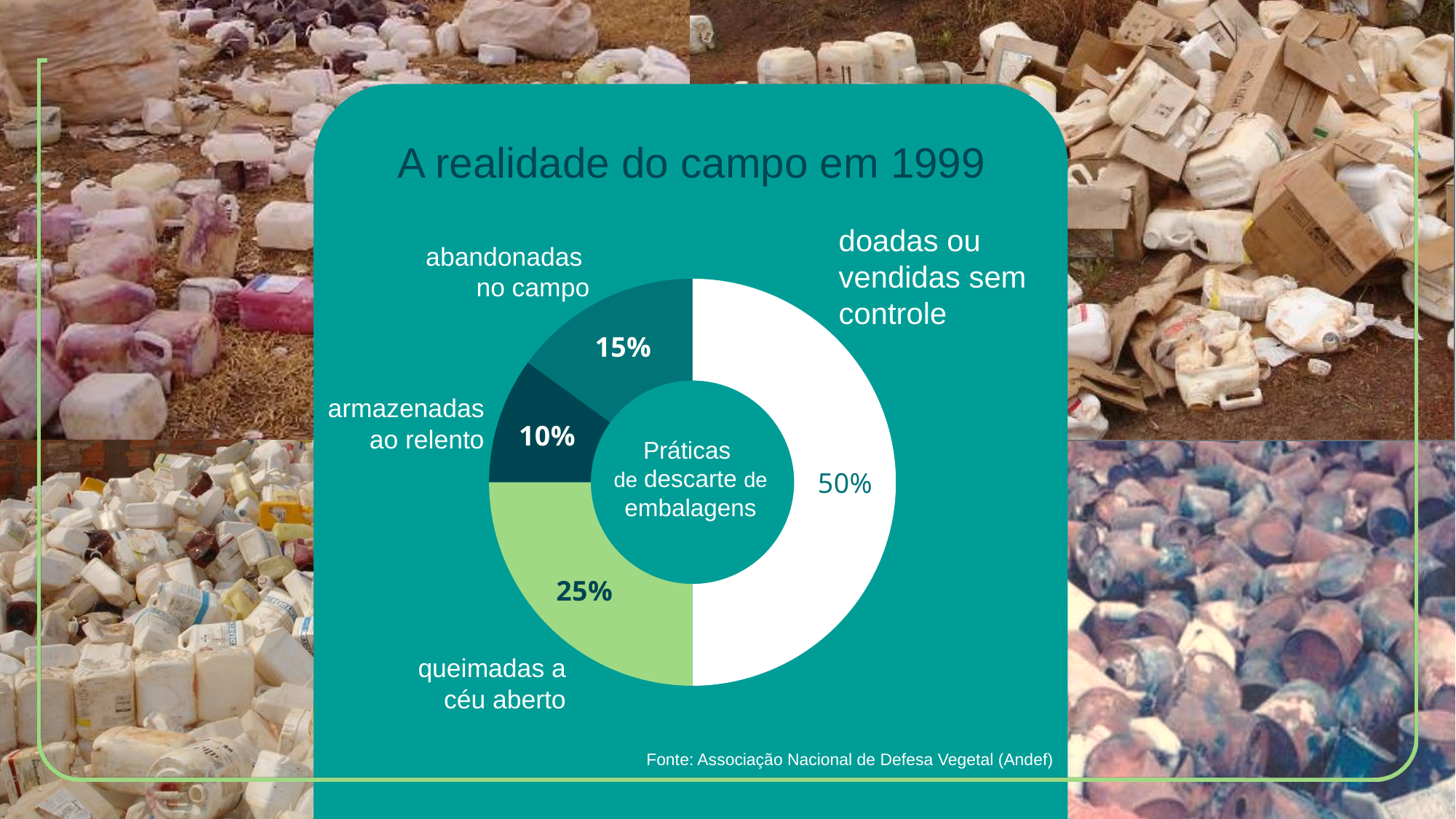
What text appears in the centre of the pie chart? Práticas de descarte de embalagens What is the title of the slide containing the chart? A realidade do campo em 1999 What value is shown for 'abandonadas no campo'? 15% What kind of chart is shown on the slide? doughnut chart What is the difference between the shares for 'queimadas a céu aberto' and 'abandonadas no campo'? 10% Which category has the largest share of the pie? doadas ou vendidas sem controle Which category has the smallest share of the pie? armazenadas ao relento What value is shown for 'queimadas a céu aberto'? 25% Which is larger: the share for 'abandonadas no campo' or for 'armazenadas ao relento'? abandonadas no campo What share of the pie is labelled 'doadas ou vendidas sem controle'? 50% How many categories does the pie chart show? 4 What value is shown for 'armazenadas ao relento'? 10%